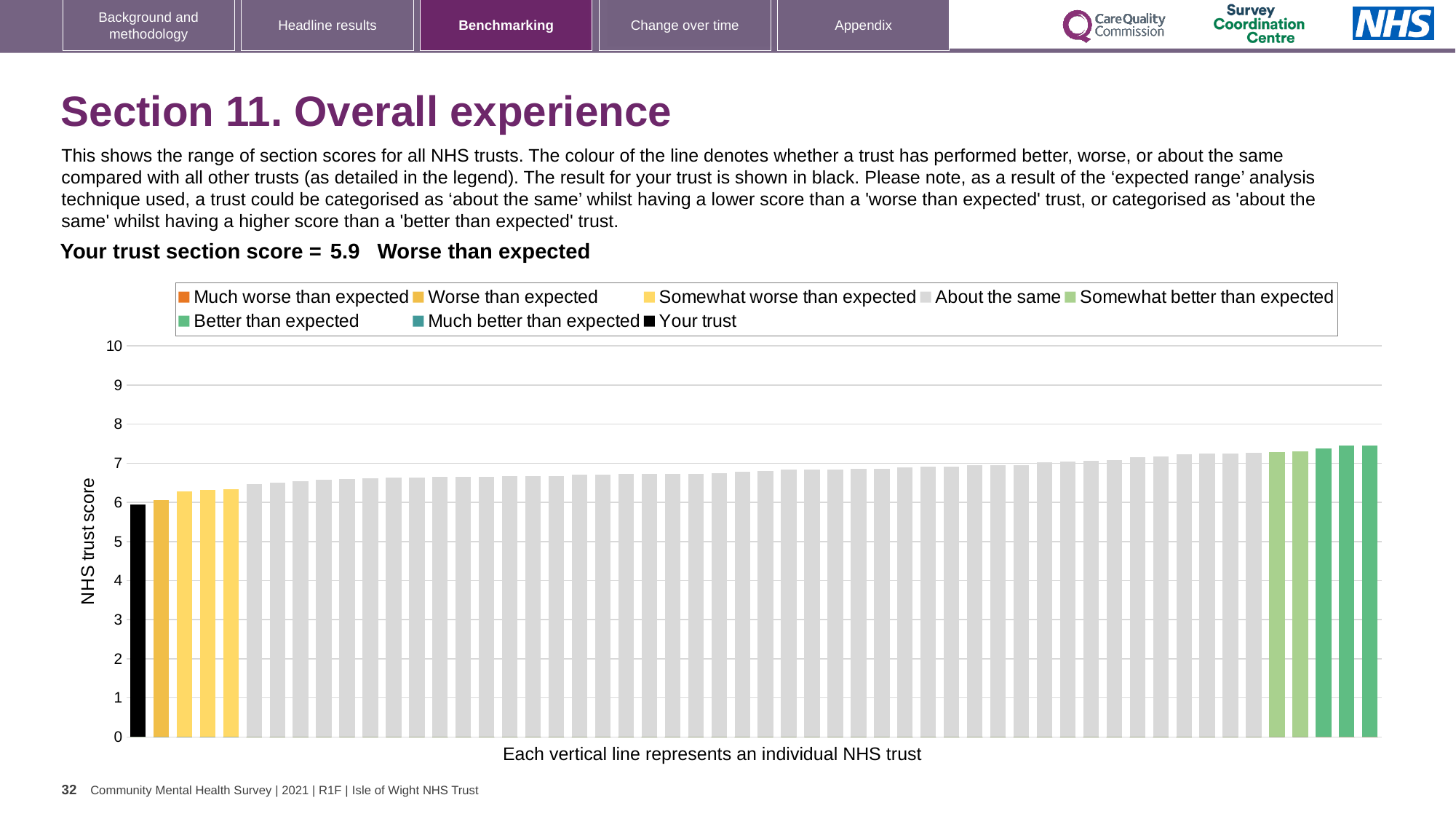
What colour is the bar representing your trust? black Is the value for your trust greater or less than 5? greater Is the value of the highest bar in the chart greater or less than 7? greater Is the value of the highest bar in the chart greater or less than 8? less What is the section score for your trust shown on the slide? 5.9 Do the bar values rise or fall from left to right along the x axis? rise Which is larger: the value for your trust or the value of the rightmost bar? the rightmost bar How many entries does the chart legend list? 8 Which bar in the chart is the lowest? Your trust (the black bar) What kind of chart is shown on the slide? bar chart What is the label on the vertical axis of the chart? NHS trust score